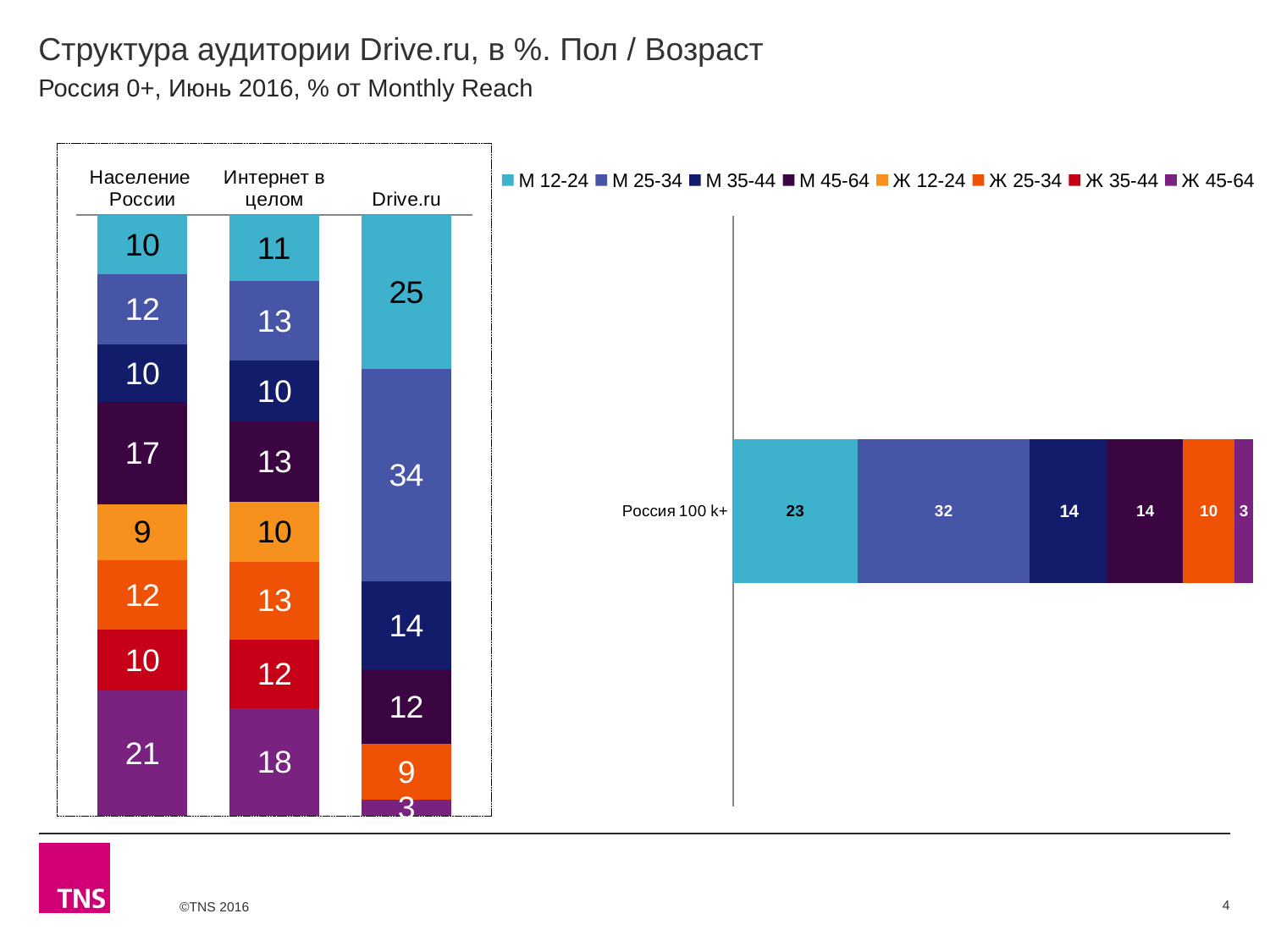
In the right chart (Россия 100 k+), which series has the largest segment? М 25-34 In the left chart, which has the larger М 12-24 value: Drive.ru or Интернет в целом? Drive.ru In the left chart, what is the value of the Ж 45-64 segment for Интернет в целом? 18 How many series does the legend list? 8 In the right chart (Россия 100 k+), how many segments make up the bar? 6 In the right chart (Россия 100 k+), what is the value of the М 12-24 segment? 23 What kind of chart is the left chart? Stacked bar chart In the left chart, what is the difference between the М 25-34 value for Drive.ru and the М 25-34 value for Население России? 22 In the right chart (Россия 100 k+), what is the total of all labelled segments in the bar? 96 In the left chart, what is the value of the Ж 45-64 segment for Население России? 21 In the left chart, what is the value of the М 25-34 segment for Drive.ru? 34 In the left chart, what is the value of the М 45-64 segment for Население России? 17